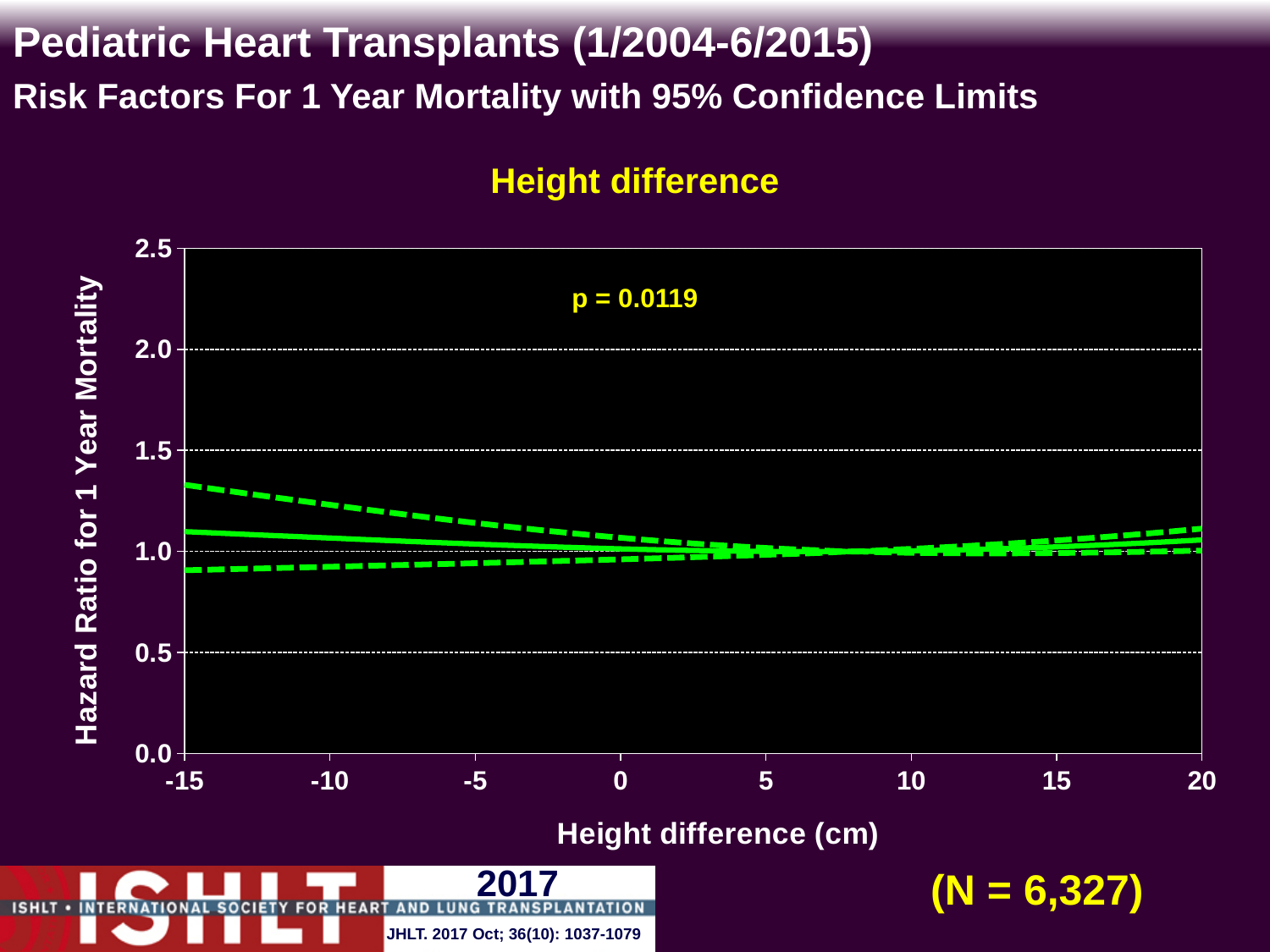
Between a height difference of -15 cm and 0 cm, does the solid hazard ratio line rise or fall? fall Is the upper confidence limit (upper dashed line) at a height difference of -15 cm greater or less than 1.0? greater What is the highest value shown on the x axis (Height difference (cm))? 20 What is the highest value shown on the y axis (Hazard Ratio for 1 Year Mortality)? 2.5 Between a height difference of -15 cm and 5 cm, does the upper confidence limit (upper dashed line) rise or fall? fall Are any of the plotted lines ever greater than 2.0 on the hazard ratio axis? no What is the lowest value shown on the x axis (Height difference (cm))? -15 What p-value is printed on the chart? p = 0.0119 What kind of chart is shown on the slide? line chart Is the upper confidence limit (upper dashed line) at a height difference of -15 cm greater or less than 1.5? less What sample size (N) is shown on the slide? N = 6,327